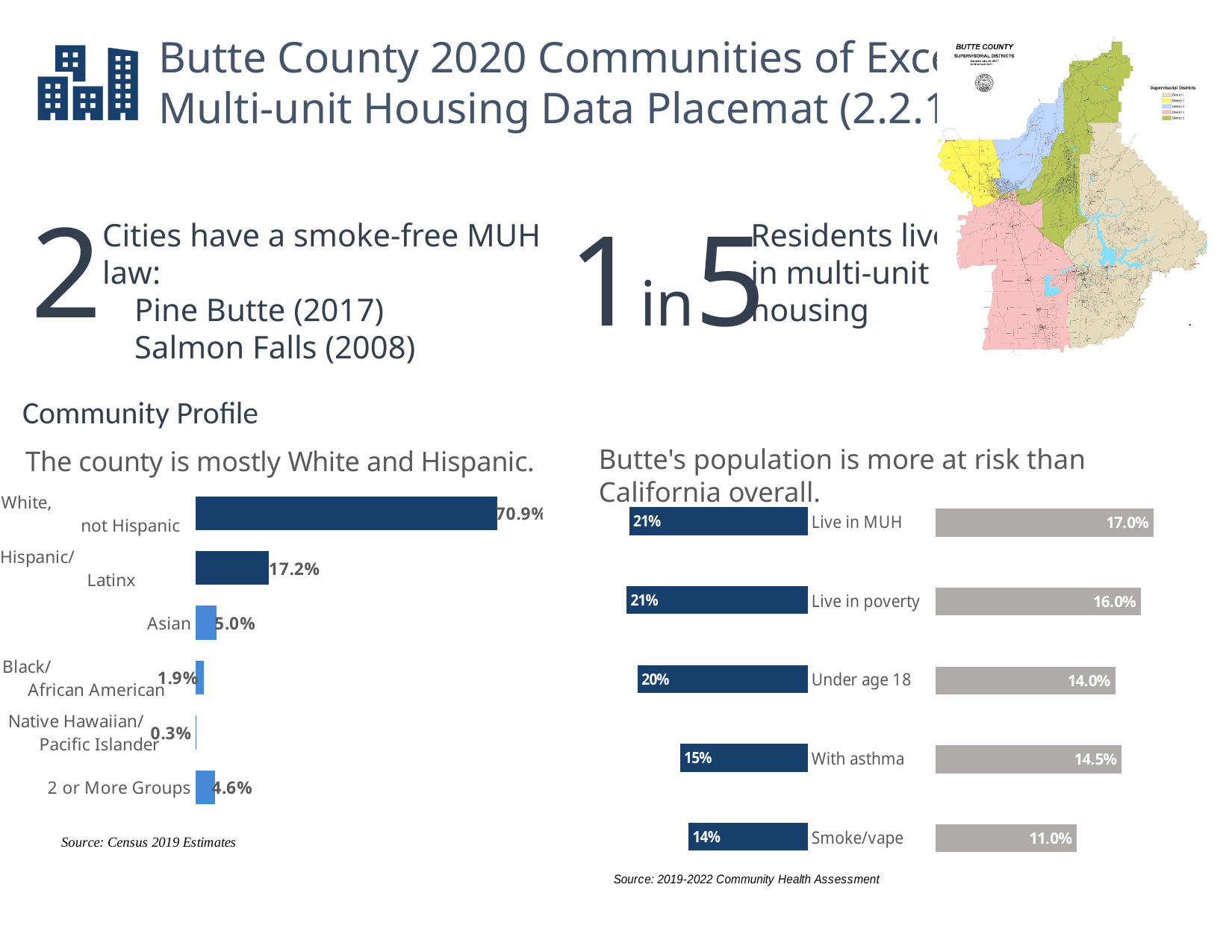
In the chart titled "The county is mostly White and Hispanic.", which category has the highest value? White, not Hispanic In the chart titled "Butte's population is more at risk than California overall.", what is the California value for With asthma? 14.5% In the chart titled "The county is mostly White and Hispanic.", which category has the lowest value? Native Hawaiian/Pacific Islander In the chart titled "The county is mostly White and Hispanic.", how many categories are shown? 6 In the chart titled "Butte's population is more at risk than California overall.", which is larger for Smoke/vape, the Butte value or the California value? Butte In the chart titled "The county is mostly White and Hispanic.", what is the value for Hispanic/Latinx? 17.2% In the chart titled "Butte's population is more at risk than California overall.", what is the difference between the Butte and California values for Under age 18? 6.0% In the chart titled "Butte's population is more at risk than California overall.", what is the Butte value for Live in poverty? 21% In the chart titled "The county is mostly White and Hispanic.", which is larger, the value for Asian or the value for Black/African American? Asian What kind of chart is the one titled "The county is mostly White and Hispanic."? Bar chart In the chart titled "The county is mostly White and Hispanic.", what is the difference between the Asian value and the 2 or More Groups value? 0.4% In the chart titled "Butte's population is more at risk than California overall.", how many categories are compared? 5